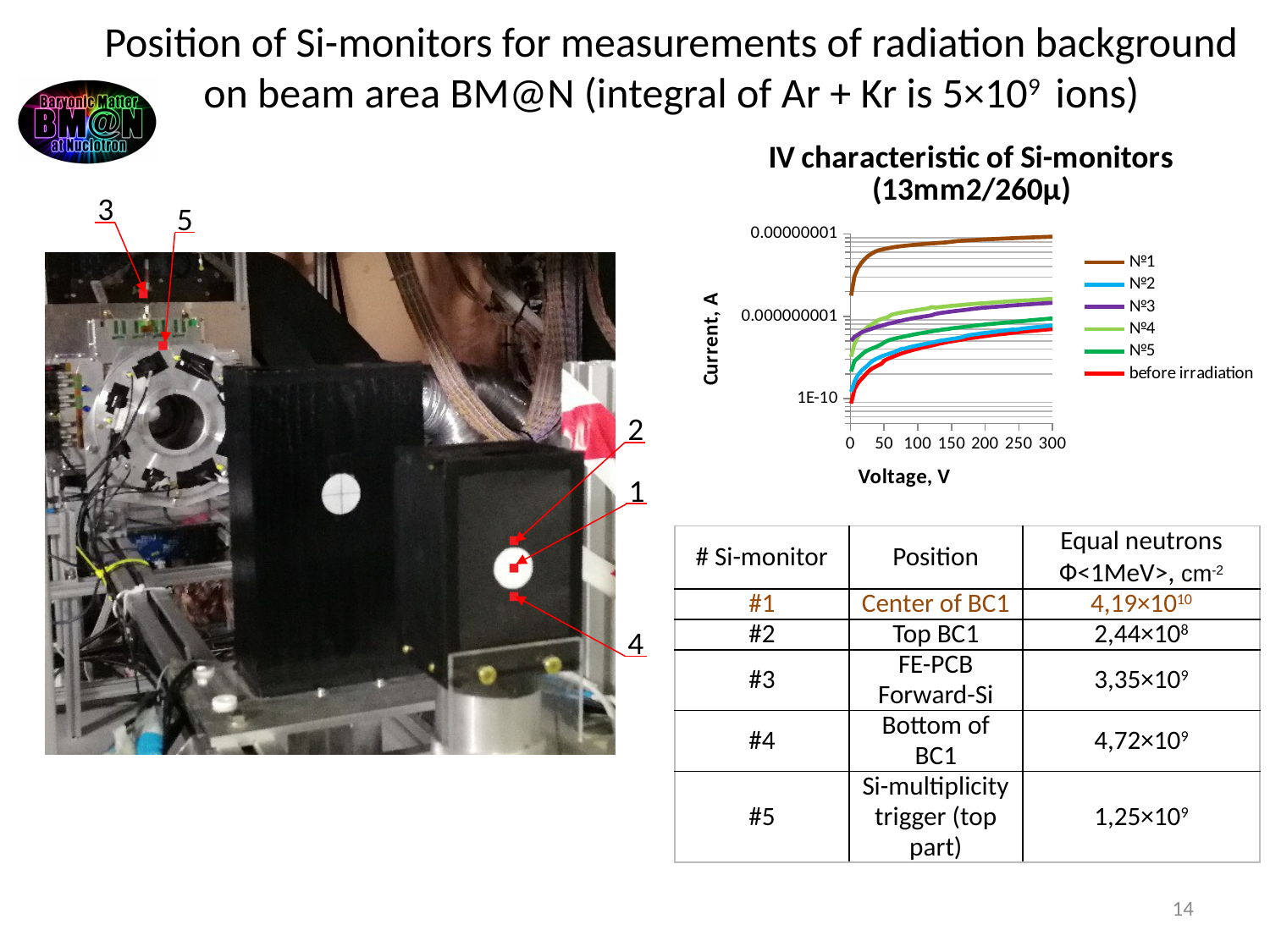
In the IV characteristic chart, which series has the larger current at 300 V, №1 or №5? №1 In the IV characteristic chart, is the current for №1 at 300 V greater or less than 0.000000001? greater In the IV characteristic chart, which series has the highest current across the voltage range? №1 In the IV characteristic chart, which series has the larger current at 300 V, №4 or №2? №4 In the IV characteristic chart, is the current for 'before irradiation' at 300 V greater or less than 0.000000001? less How many series does the legend of the IV characteristic chart list? 6 What is the label of the y axis of the IV characteristic chart? Current, A What is the label of the x axis of the IV characteristic chart? Voltage, V What kind of chart is the 'IV characteristic of Si-monitors' chart? line chart In the IV characteristic chart, is the current for №3 at 300 V greater or less than 0.000000001? greater In the IV characteristic chart, does the current rise or fall as voltage increases? rise In the IV characteristic chart, which series has the lowest current across the voltage range? before irradiation